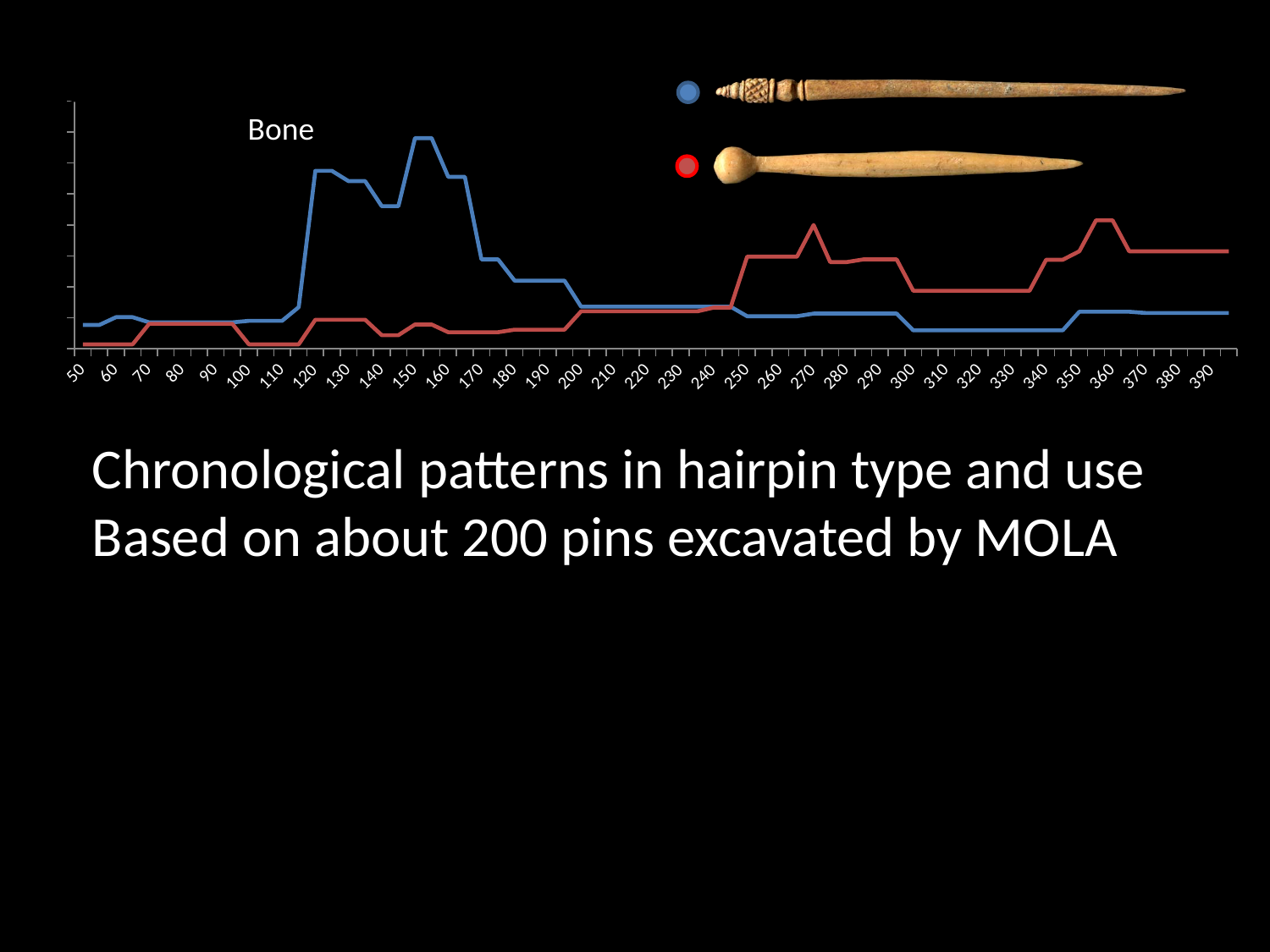
At x = 150, which line is higher, the blue line or the red line? blue Does the blue line rise or fall between x = 160 and x = 180? fall What kind of chart is shown on the slide? line chart At x = 300, which line is higher, the blue line or the red line? red Does the blue line rise or fall between x = 110 and x = 120? rise What is the last label on the x axis of the chart? 390 Does the red line rise or fall between x = 240 and x = 250? rise What is the first label on the x axis of the chart? 50 What colours are the two lines in the chart? blue and red How many labelled points are there along the x axis of the chart? 35 How many series does the chart plot? 2